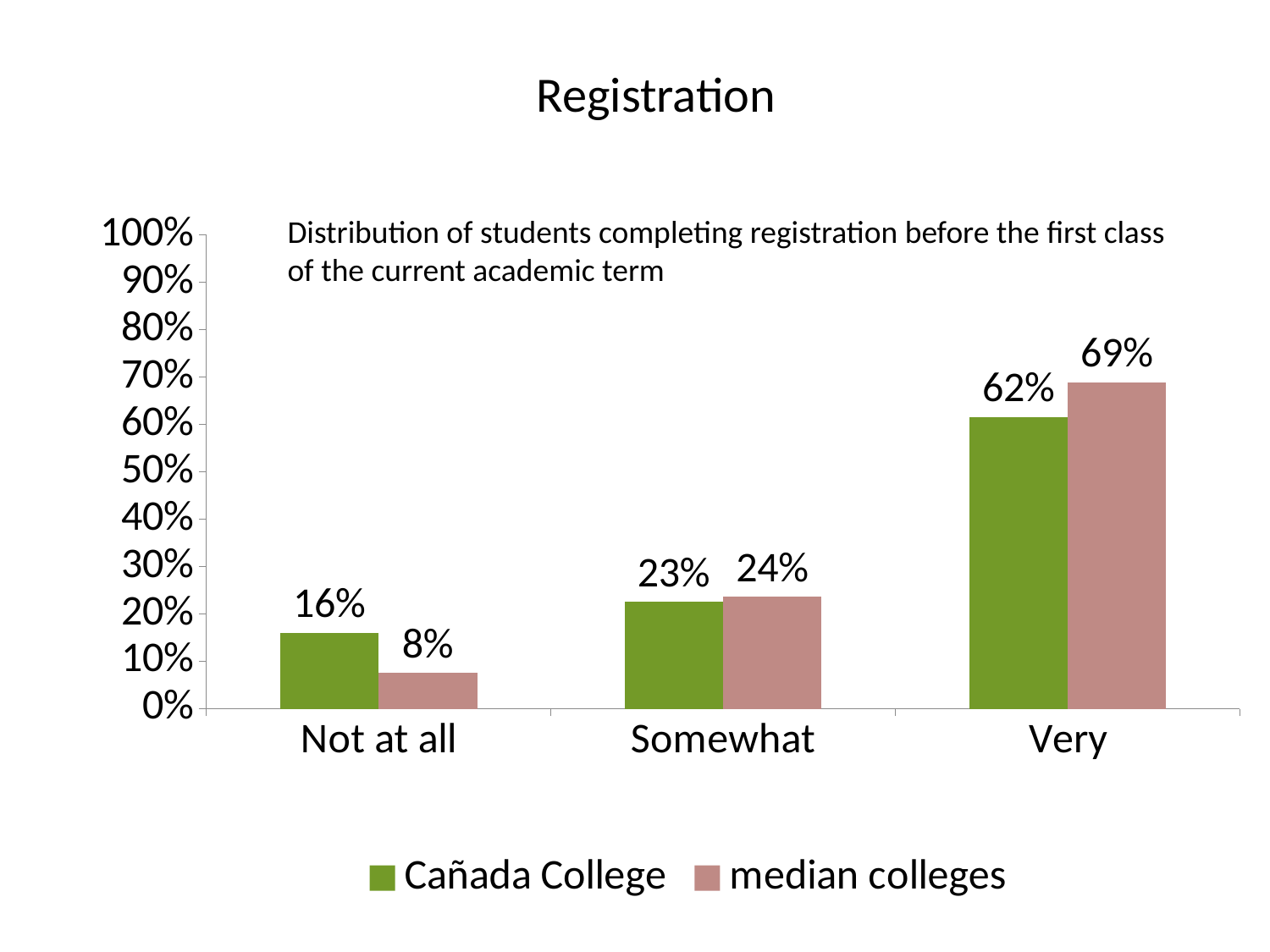
What kind of chart is shown on the slide? bar chart What is the value for median colleges in the Very category? 69% Is the value for Cañada College in the Very category greater or less than 50%? greater What is the value for median colleges in the Somewhat category? 24% How many categories are shown on the x axis? 3 What is the title of the slide? Registration What is the value for Cañada College in the Not at all category? 16% Which category has the lowest value for median colleges? Not at all How many series does the legend list? 2 Which category has the highest value for Cañada College? Very In the Not at all category, which series has the larger value, Cañada College or median colleges? Cañada College What is the difference between the median colleges value and the Cañada College value in the Very category? 7%